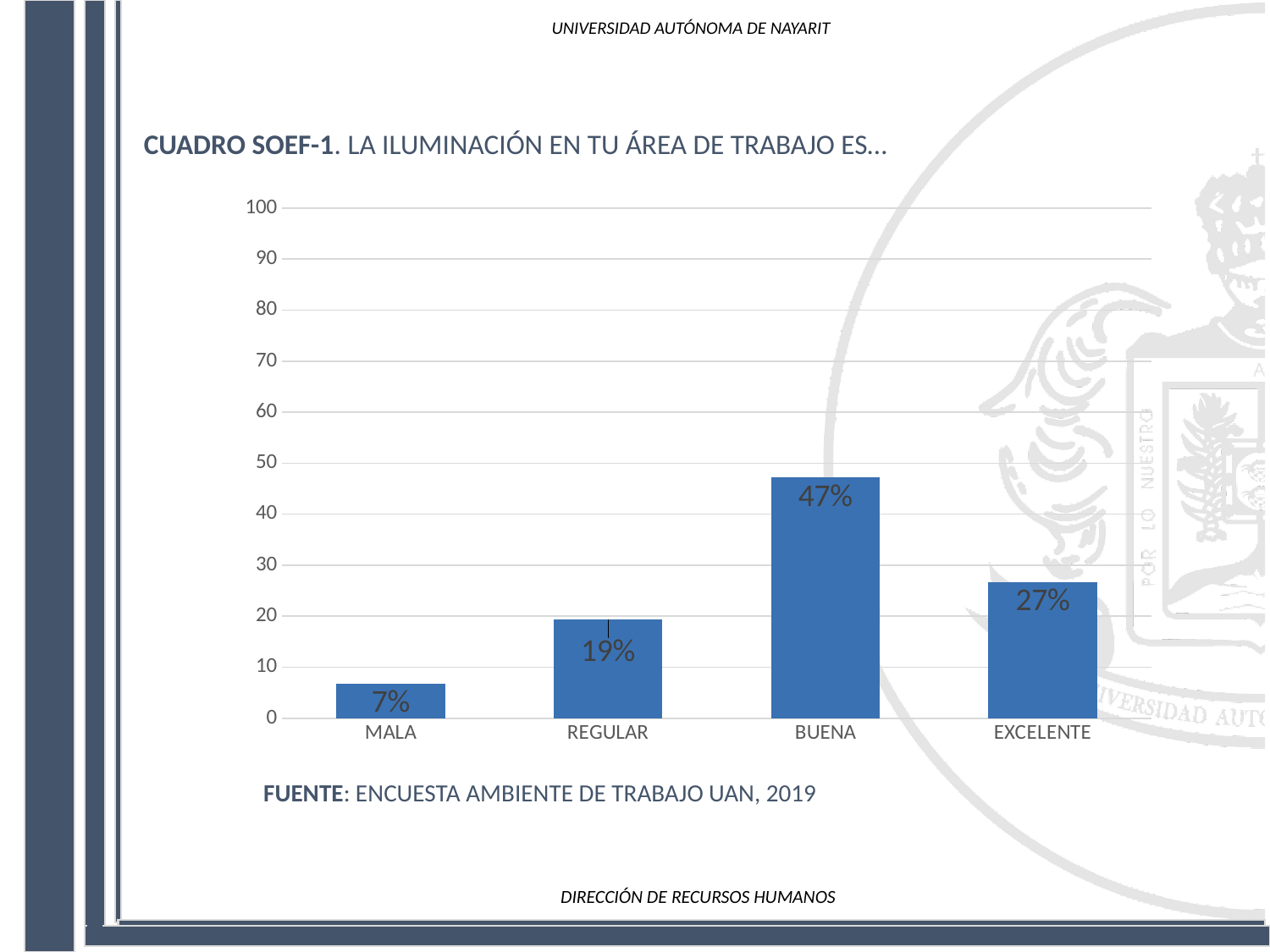
What is the value for REGULAR? 19% Which is larger, the value for REGULAR or the value for EXCELENTE? EXCELENTE What is the source cited below the chart? ENCUESTA AMBIENTE DE TRABAJO UAN, 2019 How many categories are shown on the x axis? 4 Which category has the highest value? BUENA What is the value for EXCELENTE? 27% What is the value for MALA? 7% What is the value for BUENA? 47% Is the value for BUENA greater or less than 40? greater What is the difference between the values for BUENA and EXCELENTE? 20% Which category has the lowest value? MALA What kind of chart is shown on the slide? bar chart